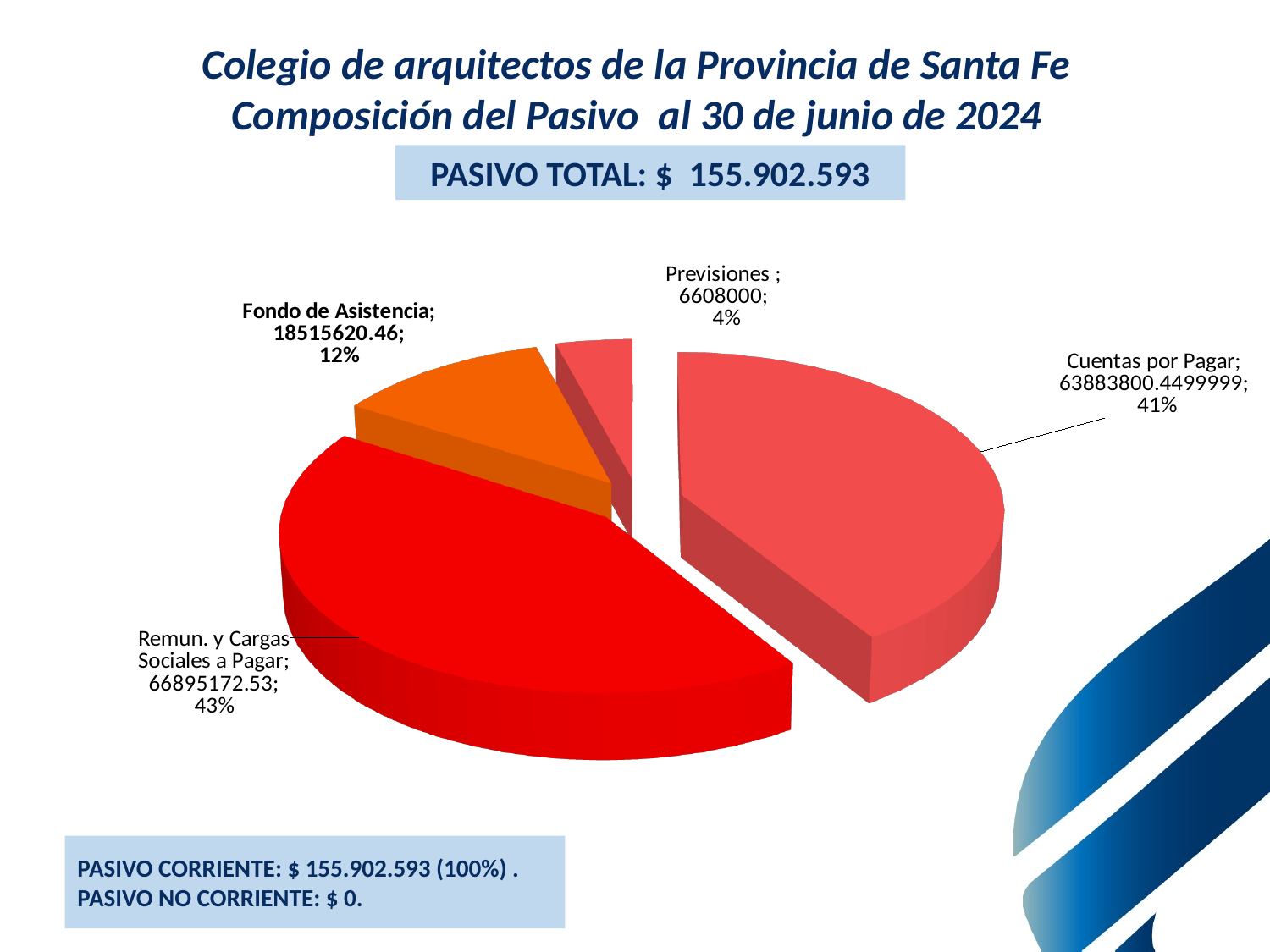
Which category has the largest share of the pie? Remun. y Cargas Sociales a Pagar What value is shown for Previsiones? 6608000 What percentage share does the Previsiones slice represent? 4% Which is larger, the share for Fondo de Asistencia or the share for Previsiones? Fondo de Asistencia What value is shown for Fondo de Asistencia? 18515620.46 What kind of chart is shown on the slide? pie chart What value is shown for Cuentas por Pagar? 63883800.4499999 What total liability (PASIVO TOTAL) is stated above the chart? $ 155.902.593 How many slices does the pie chart have? 4 Which category has the smallest share of the pie? Previsiones What is the difference in percentage points between the Cuentas por Pagar share and the Fondo de Asistencia share? 29 What percentage share does the Remun. y Cargas Sociales a Pagar slice represent? 43%